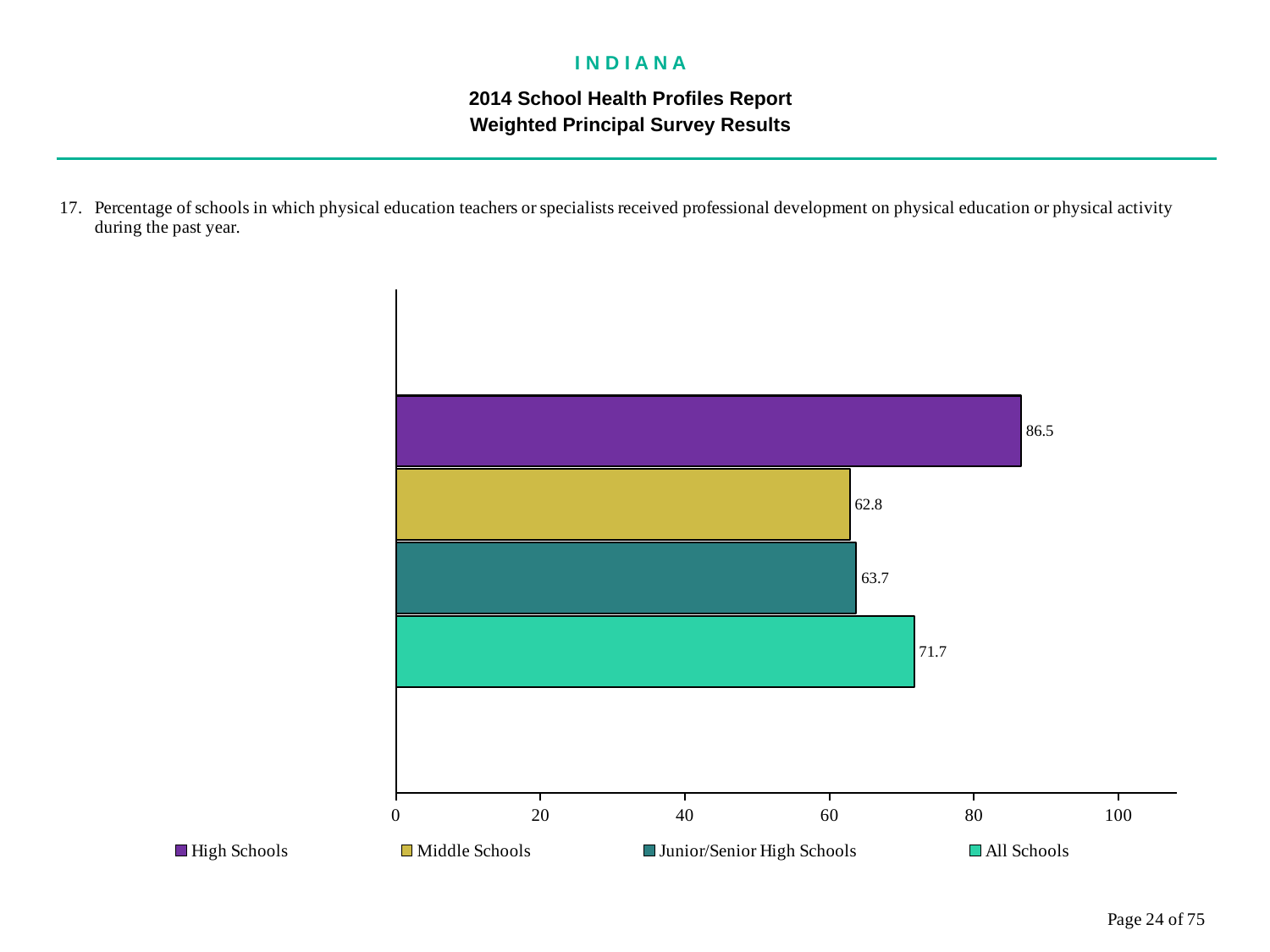
What is the difference between the High Schools value and the All Schools value? 14.8 What is the value for All Schools? 71.7 Which school category has the highest value? High Schools What is the value for Middle Schools? 62.8 What is the value for Junior/Senior High Schools? 63.7 Which school category has the lowest value? Middle Schools How many series does the legend list? 4 What is the difference between the Junior/Senior High Schools value and the Middle Schools value? 0.9 What is the value for High Schools? 86.5 Is the value for All Schools greater or less than 80? less Which is larger, the value for High Schools or the value for All Schools? High Schools What kind of chart is shown on the slide? bar chart